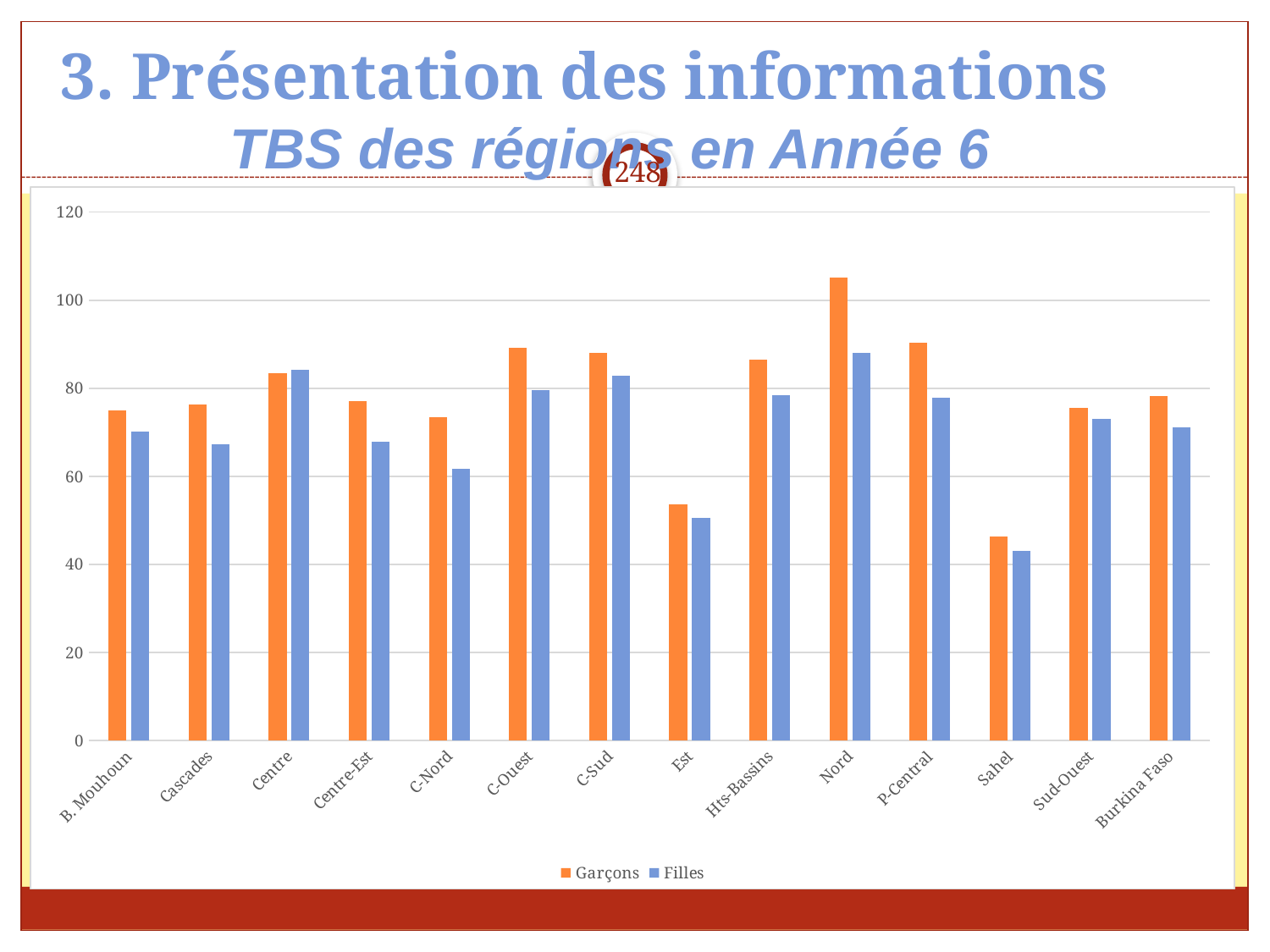
How many series does the legend list? 2 Is the Garçons value for Est greater or less than 60? less Which region has the lowest value for Filles? Sahel Is the Filles value for Centre greater or less than 80? greater How many categories are shown on the x axis? 14 Which is larger, the Filles value for Est or the Filles value for Sahel? Est Is the Garçons value for Nord greater or less than 100? greater Which series is shown in orange? Garçons Which region has the highest value for Garçons? Nord Which region has the lowest value for Garçons? Sahel What kind of chart is shown on the slide? bar chart